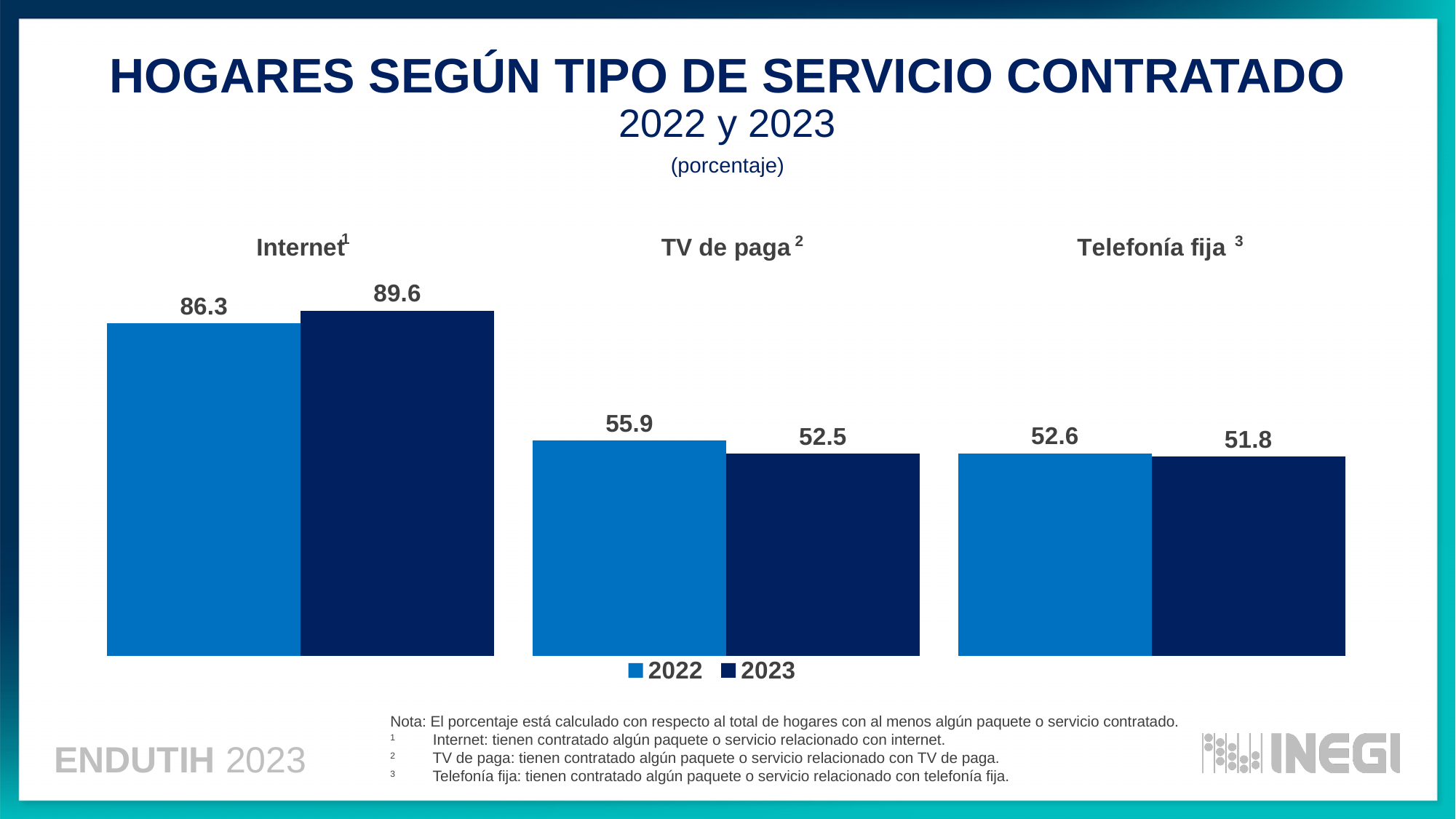
What kind of chart is shown on the slide? Bar chart Which service has the lowest value in 2022? Telefonía fija What is the value for Internet in 2022? 86.3 By how much did the value for Internet increase from 2022 to 2023? 3.3 What is the difference between the 2022 and 2023 values for TV de paga? 3.4 What is the value for Internet in 2023? 89.6 Which is larger for Telefonía fija, the 2022 value or the 2023 value? 2022 Which service has the highest value in 2023? Internet How many series does the legend list? 2 How many service categories are shown in the chart? 3 What is the value for TV de paga in 2022? 55.9 What is the value for Telefonía fija in 2023? 51.8